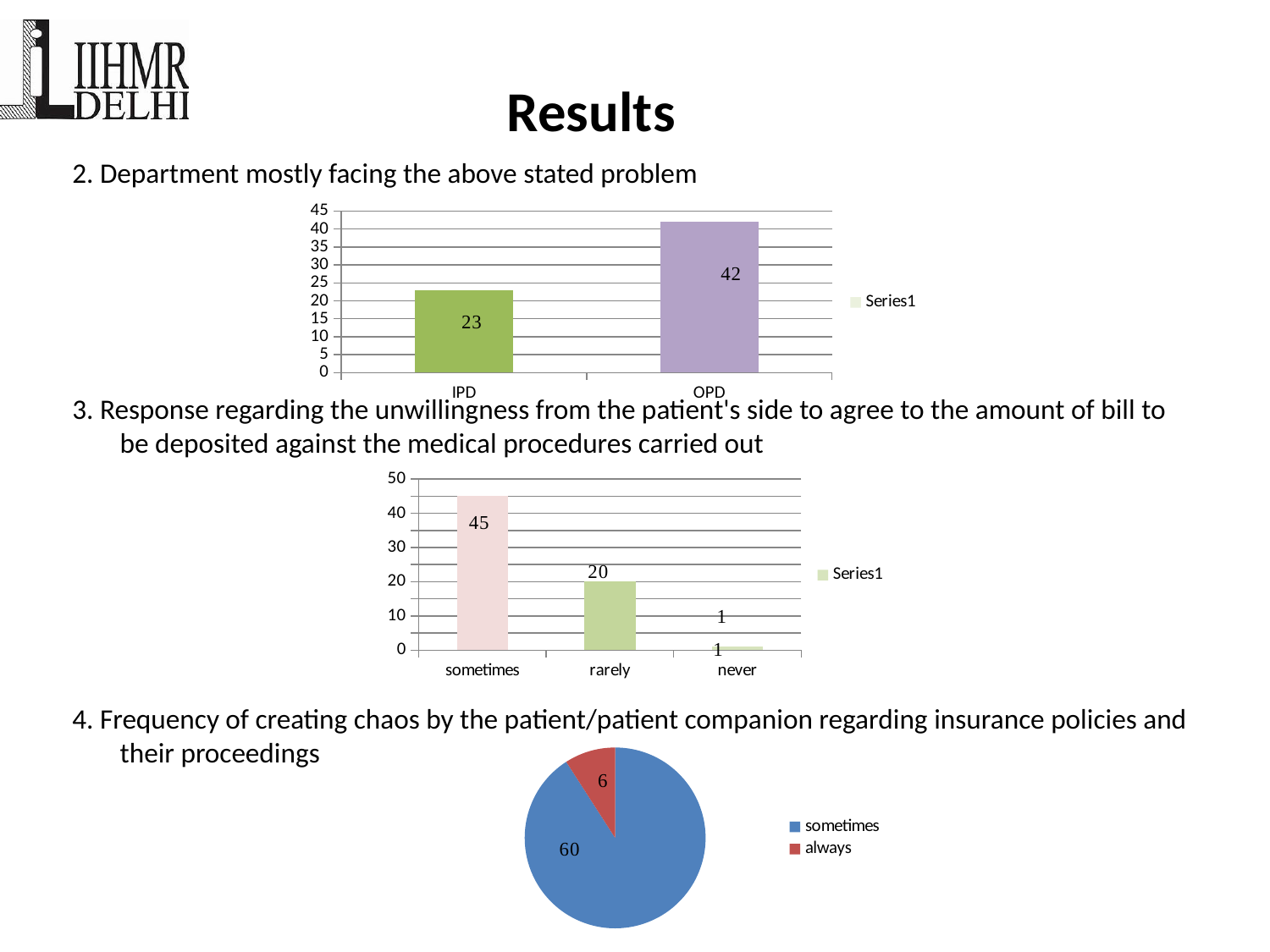
In the top chart (Department mostly facing the above stated problem), what is the difference between the OPD and IPD values? 19 In the middle chart (Response regarding the unwillingness from the patient's side), what is the value for 'rarely'? 20 What kind of chart is the bottom chart (Frequency of creating chaos by the patient/patient companion)? pie chart In the top chart (Department mostly facing the above stated problem), which category has the higher value? OPD In the bottom chart (Frequency of creating chaos by the patient/patient companion), which slice is larger, 'sometimes' or 'always'? sometimes In the middle chart (Response regarding the unwillingness from the patient's side), how many categories are shown on the x axis? 3 In the middle chart (Response regarding the unwillingness from the patient's side), what is the difference between the 'sometimes' and 'rarely' values? 25 In the top chart (Department mostly facing the above stated problem), what is the value for OPD? 42 In the top chart (Department mostly facing the above stated problem), what is the value for IPD? 23 In the bottom chart (Frequency of creating chaos by the patient/patient companion), what is the value for 'always'? 6 In the middle chart (Response regarding the unwillingness from the patient's side), which category has the lowest value? never In the middle chart (Response regarding the unwillingness from the patient's side), do the values rise or fall from left to right along the x axis? fall